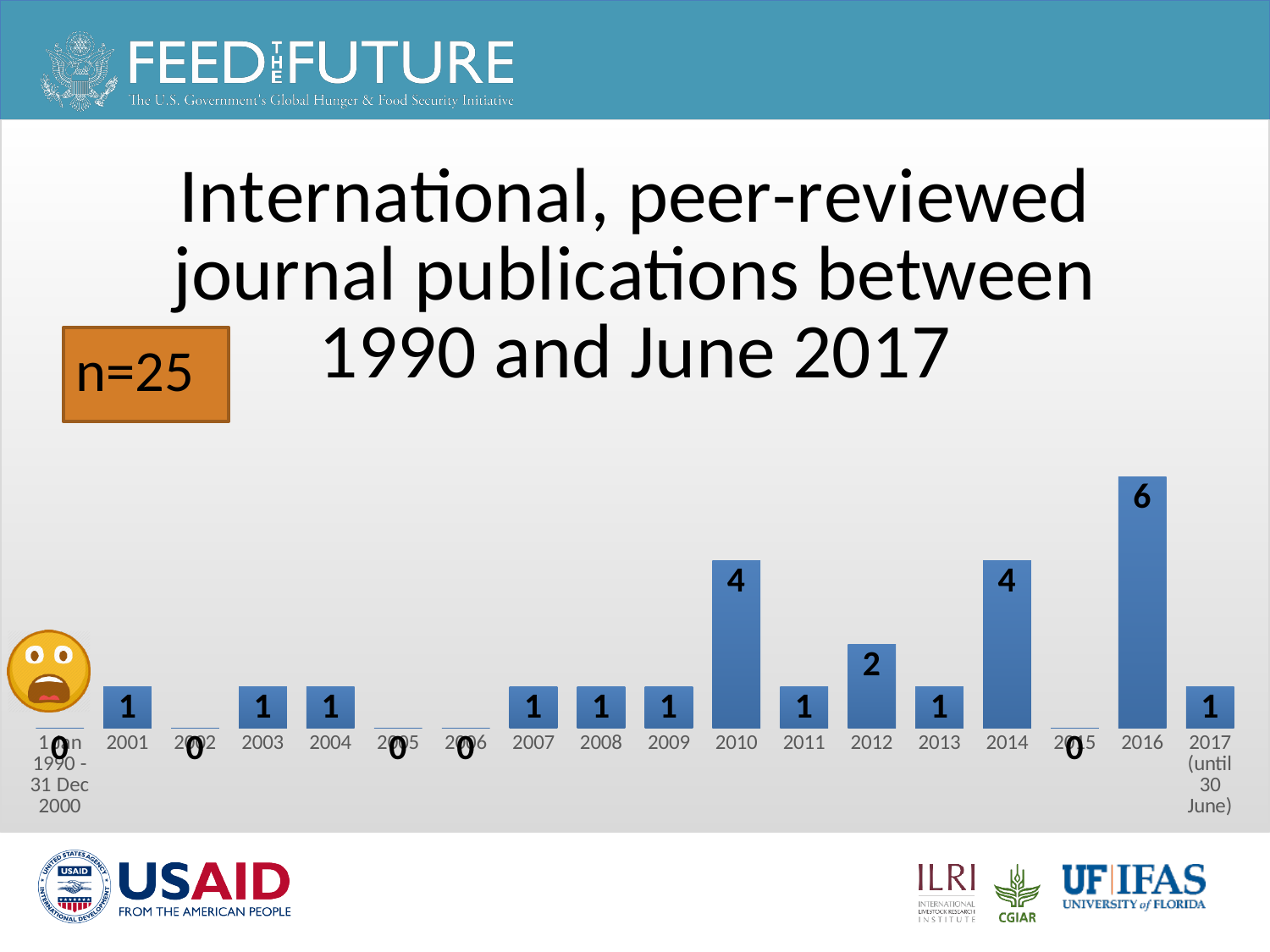
What is the difference between the values for 2012 and 2011? 1 What is the value for 2017 (until 30 June)? 1 What kind of chart is shown on the slide? Bar chart What is the value for 2012? 2 What is the difference between the values for 2016 and 2014? 2 Which year has the highest number of publications? 2016 What is the value for 2015? 0 What value of n is shown in the orange box on the slide? n=25 How many categories are shown on the x axis? 18 Which is larger, the value for 2010 or the value for 2012? 2010 What is the value for 2016? 6 What is the value for 2010? 4